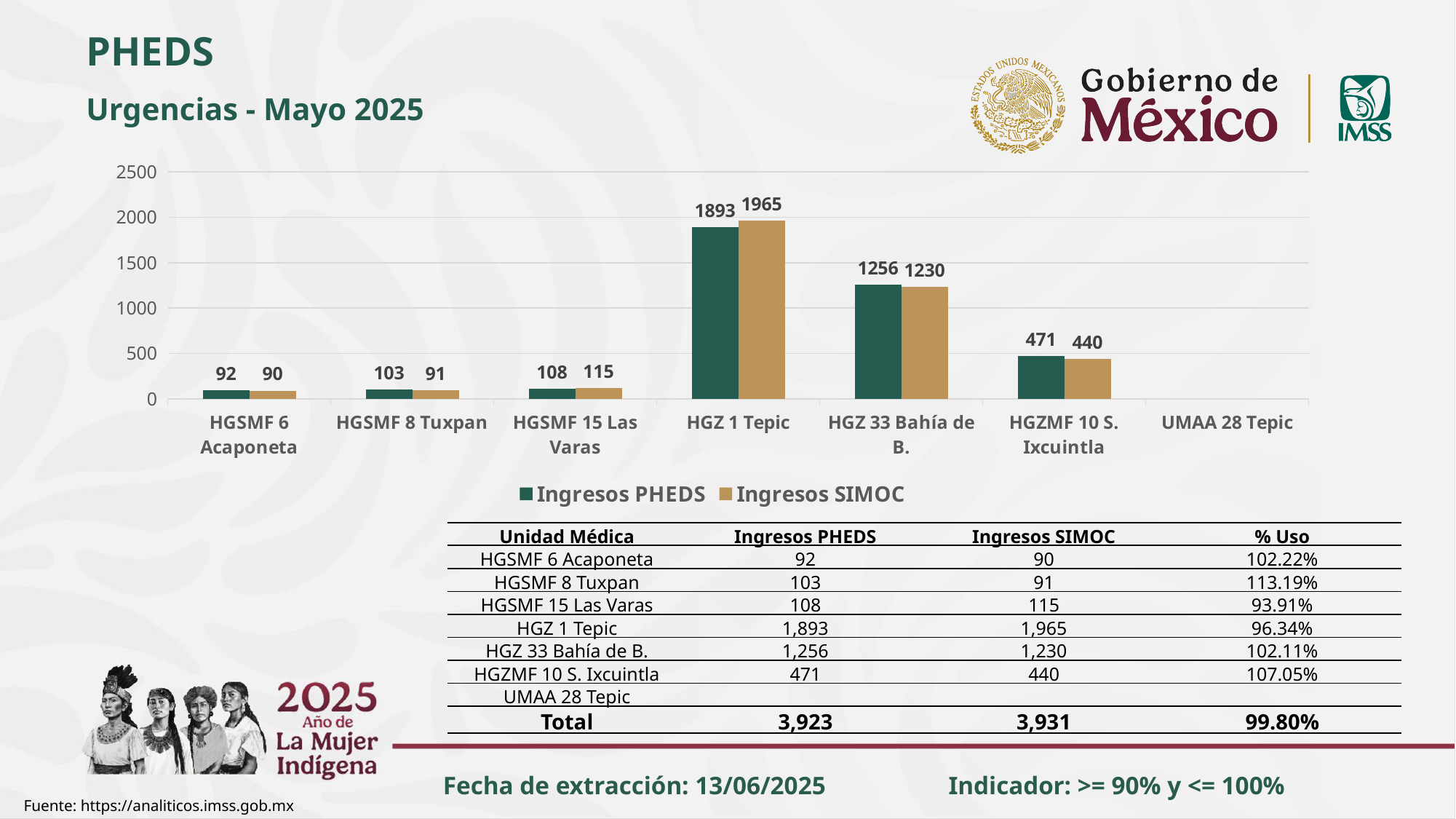
For HGZ 33 Bahía de B., which is larger: Ingresos PHEDS or Ingresos SIMOC? Ingresos PHEDS Which series is shown in dark green in the chart? Ingresos PHEDS Which unit with a plotted bar has the lowest Ingresos SIMOC value? HGSMF 6 Acaponeta How many units are listed on the x axis of the chart? 7 What is the Ingresos PHEDS value for HGZ 1 Tepic? 1893 Which unit has the highest Ingresos PHEDS value? HGZ 1 Tepic What kind of chart is shown on the slide? bar chart What is the difference between Ingresos SIMOC and Ingresos PHEDS for HGZ 1 Tepic? 72 Is the Ingresos PHEDS value for HGZ 33 Bahía de B. greater or less than 1000? greater What is the Ingresos SIMOC value for HGZMF 10 S. Ixcuintla? 440 How many series does the legend list? 2 What is the Ingresos SIMOC value for HGSMF 15 Las Varas? 115